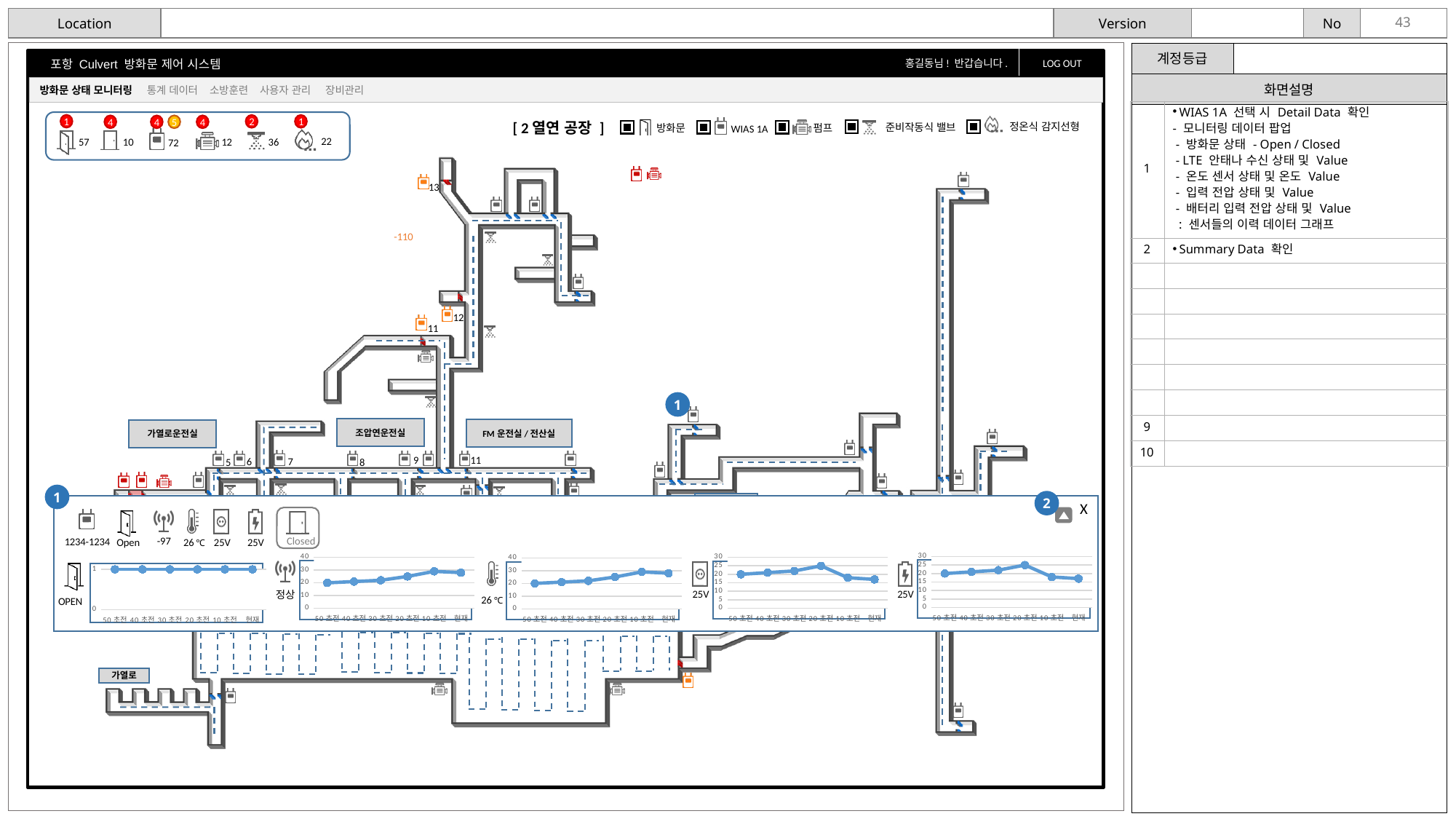
In the fourth history chart (25V, input voltage), which x-axis category has the highest value? 20초전 In the fifth history chart (25V, battery), which x-axis category has the highest value? 20초전 What is the highest y-axis tick shown on the second history chart (LTE signal, 정상)? 40 What is the label of the last x-axis category in the history charts? 현재 What kind of chart is used for the sensor history graphs in the popup at the bottom of the slide? line chart In the third history chart (temperature, 26 ℃), is the value for 50초전 greater or less than 30? less In the second history chart (LTE signal, 정상), is the value for 50초전 greater or less than 30? less In the second history chart (LTE signal, 정상), do the values generally rise or fall from 50초전 to 현재? rise In the leftmost history chart (OPEN), how many data points are plotted along the x axis? 6 In the leftmost history chart (OPEN), do the values rise, fall, or stay flat along the x axis? stay flat How many small history charts are shown in the popup at the bottom of the slide? 5 In the fourth history chart (25V, input voltage), is the value for 현재 greater or less than 20? less